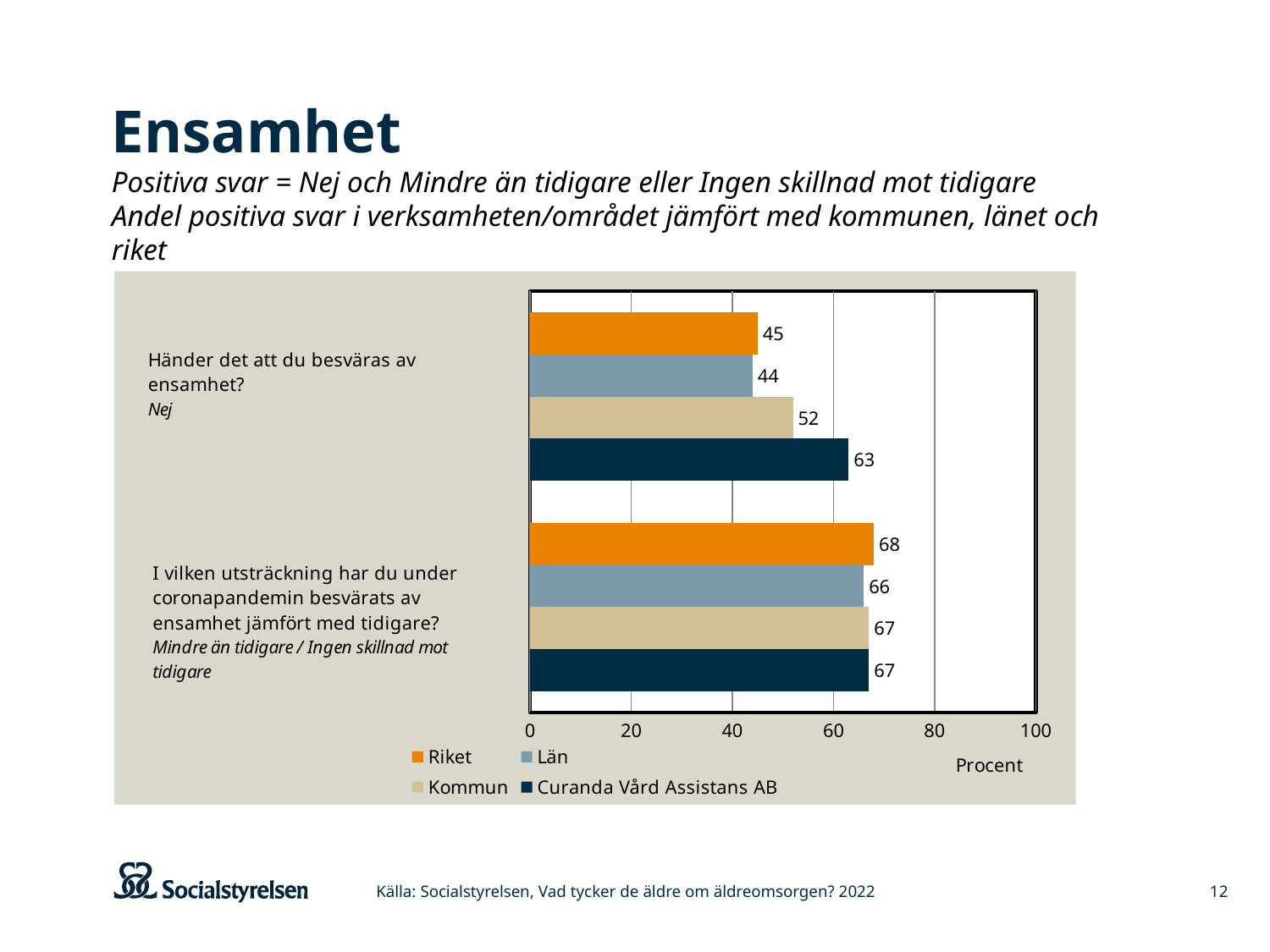
Which series has the highest value for the question "Händer det att du besväras av ensamhet?"? Curanda Vård Assistans AB Is the Kommun value for the question "Händer det att du besväras av ensamhet?" greater or less than 60? less Which series has the lowest value for the question "Händer det att du besväras av ensamhet?"? Län What is the value for Riket for the question "I vilken utsträckning har du under coronapandemin besvärats av ensamhet jämfört med tidigare?"? 68 For the question "I vilken utsträckning har du under coronapandemin besvärats av ensamhet jämfört med tidigare?", which is larger: Riket or Län? Riket What is the difference between the Curanda Vård Assistans AB value and the Riket value for the question "Händer det att du besväras av ensamhet?"? 18 What is the label on the horizontal axis of the chart? Procent How many question categories are shown on the chart? 2 What kind of chart is shown on the slide? bar chart What is the value for Län for the question "Händer det att du besväras av ensamhet?"? 44 How many series does the legend list? 4 What is the value for Curanda Vård Assistans AB for the question "Händer det att du besväras av ensamhet?"? 63